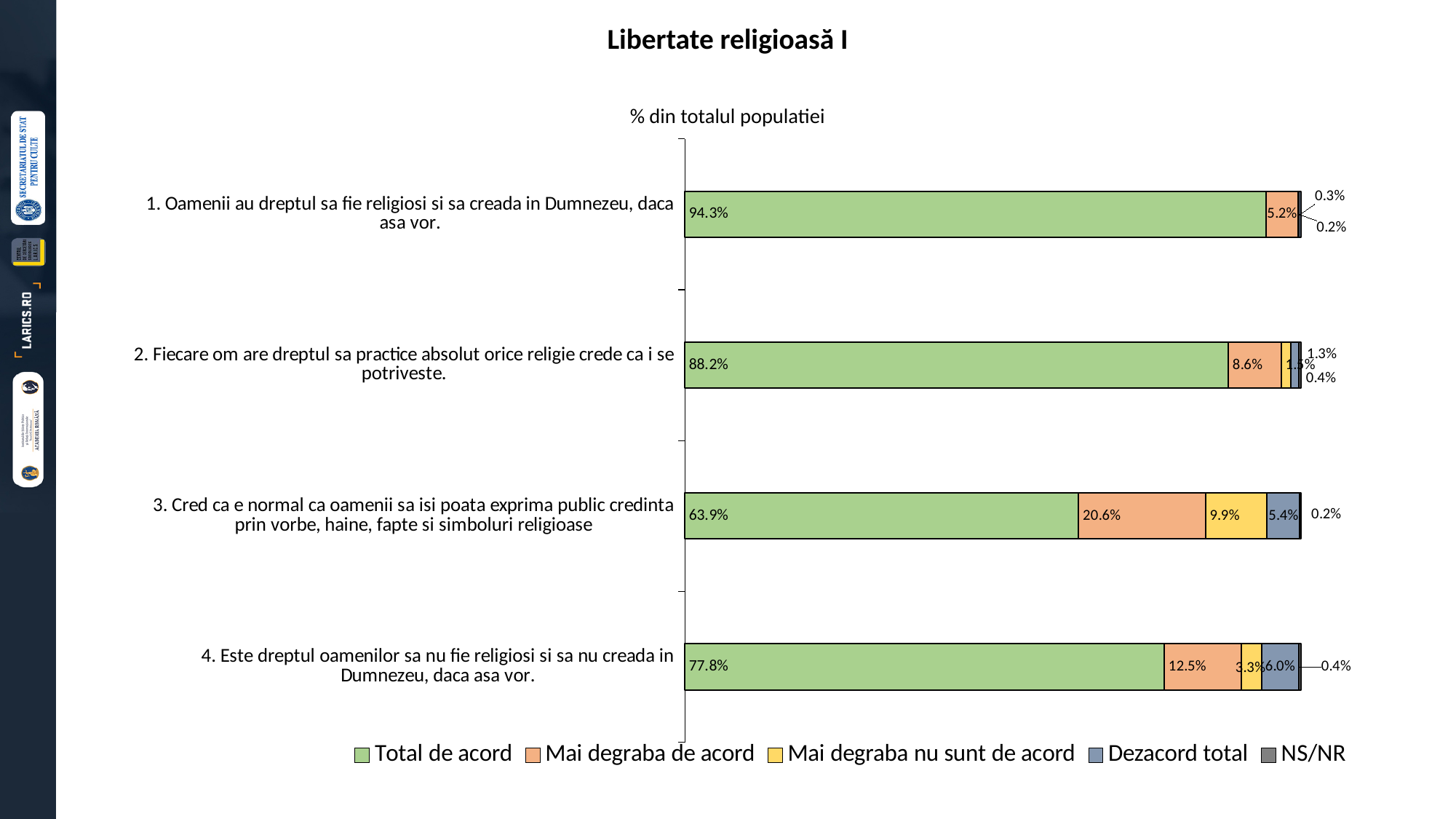
Which statement has the highest 'Total de acord' value? 1. Oamenii au dreptul sa fie religiosi si sa creada in Dumnezeu, daca asa vor. What is the 'Total de acord' value for statement 1 (Oamenii au dreptul sa fie religiosi si sa creada in Dumnezeu, daca asa vor.)? 94.3% How many statements (categories) are shown in the chart? 4 What is the title shown above the chart? % din totalul populatiei What is the difference between the 'Total de acord' values for statement 1 and statement 2? 6.1 percentage points Which has the larger 'Mai degraba de acord' value: statement 2 or statement 4? Statement 4 How many series does the legend list? 5 What is the 'Mai degraba nu sunt de acord' value for statement 3? 9.9% What is the 'Dezacord total' value for statement 4 (Este dreptul oamenilor sa nu fie religiosi si sa nu creada in Dumnezeu, daca asa vor.)? 6.0% What kind of chart is shown on the slide? Stacked bar chart What is the 'Mai degraba de acord' value for statement 3 (Cred ca e normal ca oamenii sa isi poata exprima public credinta prin vorbe, haine, fapte si simboluri religioase)? 20.6% Which statement has the lowest 'Total de acord' value? 3. Cred ca e normal ca oamenii sa isi poata exprima public credinta prin vorbe, haine, fapte si simboluri religioase